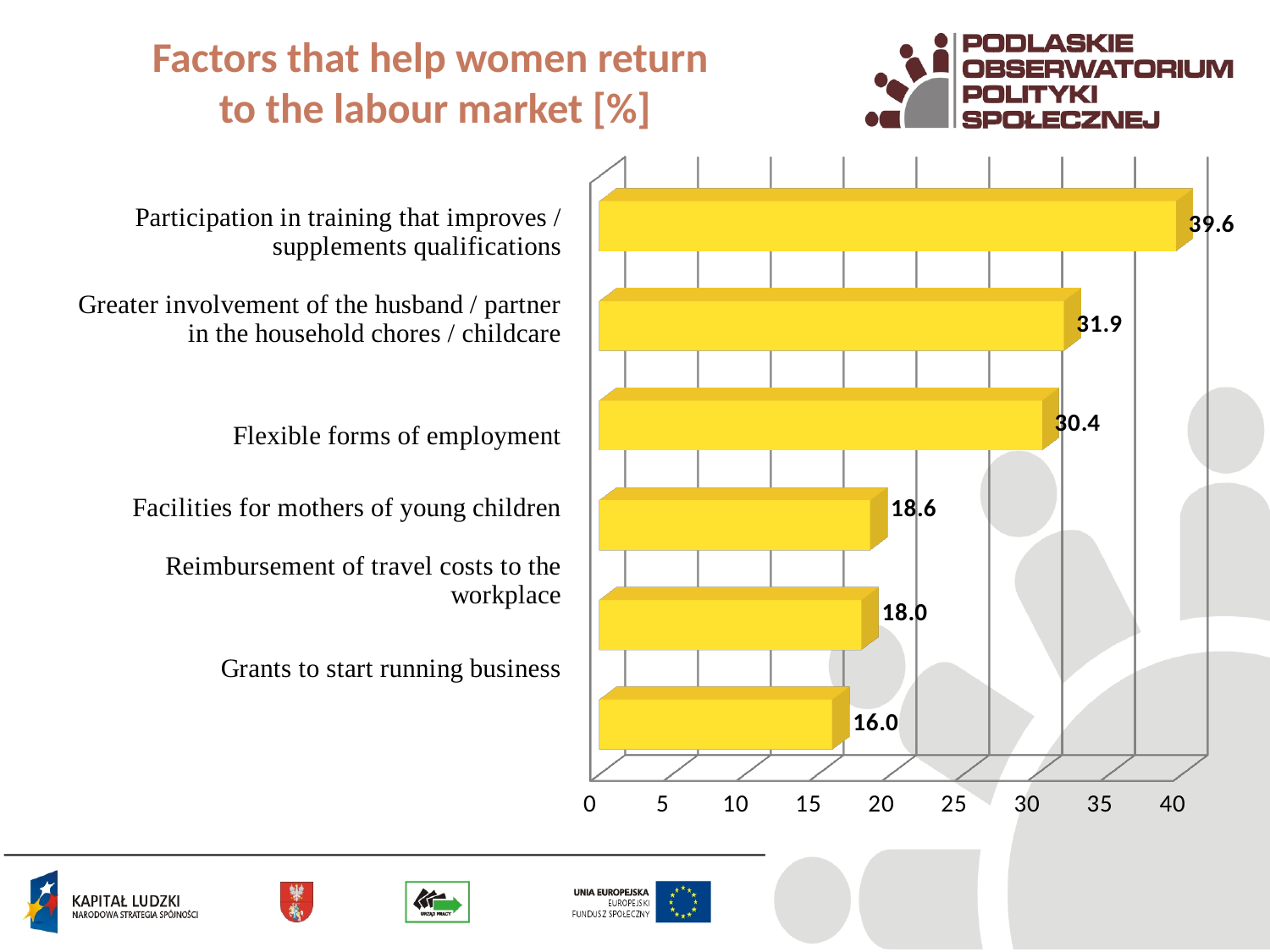
Which factor has the lowest value? Grants to start running business What is the title of the chart? Factors that help women return to the labour market [%] What is the value for 'Grants to start running business'? 16.0 How many factors are shown in the chart? 6 Which factor has the highest value? Participation in training that improves / supplements qualifications Which is larger: the value for 'Greater involvement of the husband / partner in the household chores / childcare' or for 'Flexible forms of employment'? Greater involvement of the husband / partner in the household chores / childcare What is the value for 'Flexible forms of employment'? 30.4 What is the value for 'Participation in training that improves / supplements qualifications'? 39.6 What kind of chart is shown on the slide? bar chart Is the value for 'Reimbursement of travel costs to the workplace' greater or less than 20? less What is the difference between the values for 'Participation in training that improves / supplements qualifications' and 'Greater involvement of the husband / partner in the household chores / childcare'? 7.7 What is the value for 'Facilities for mothers of young children'? 18.6